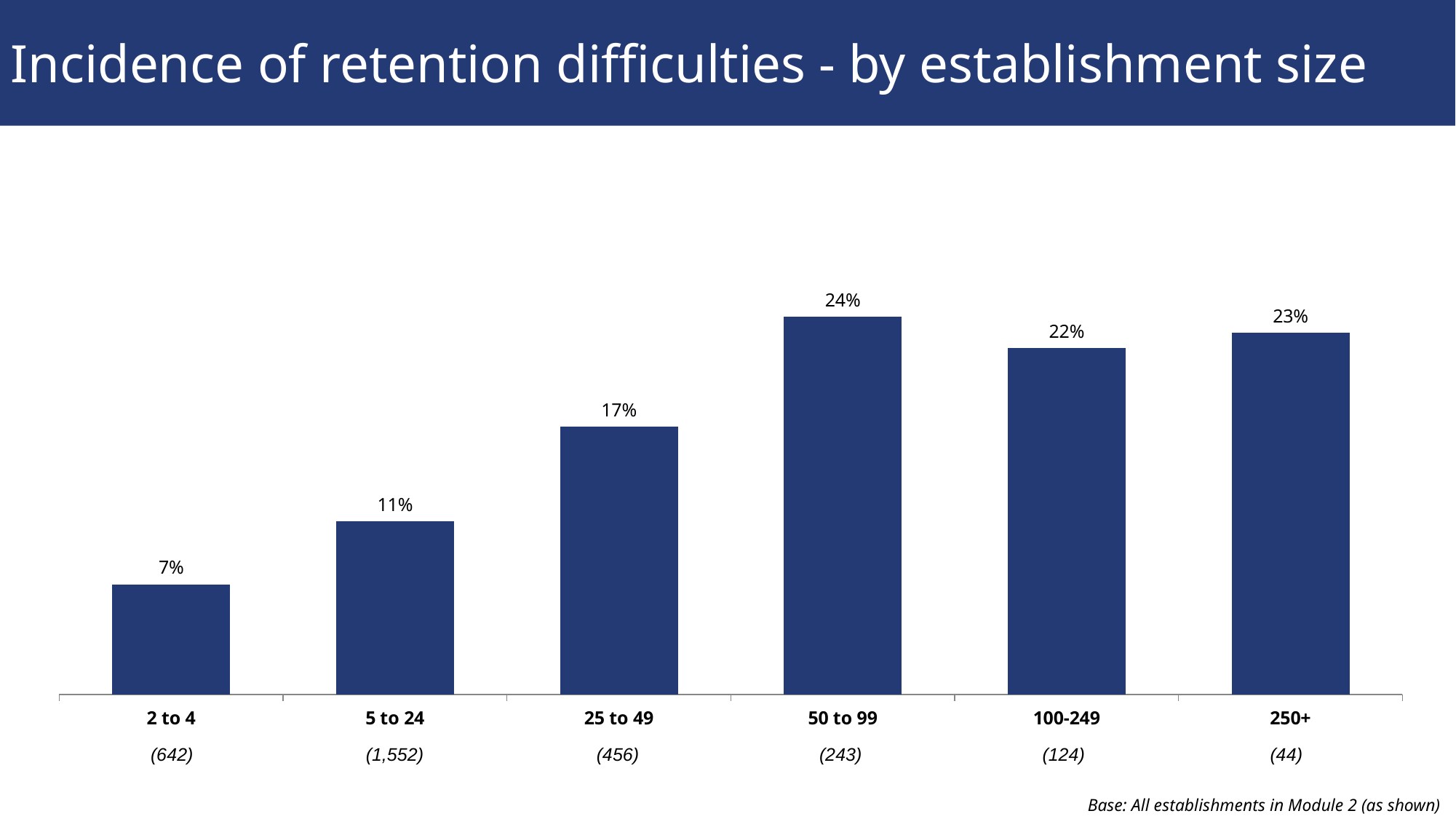
How many establishment size bands are shown on the chart? 6 Which establishment size band has the highest incidence of retention difficulties? 50 to 99 What is the difference in percentage points between the 50 to 99 band and the 100-249 band? 2 percentage points Which establishment size band has the lowest incidence of retention difficulties? 2 to 4 What kind of chart is shown on the slide? Bar chart What is the difference in percentage points between the 25 to 49 band and the 5 to 24 band? 6 percentage points Which has a higher incidence of retention difficulties: the 100-249 band or the 250+ band? 250+ What is the title of the chart on the slide? Incidence of retention difficulties - by establishment size What is the value shown for the 250+ establishment size band? 23% What is the value shown for the 50 to 99 establishment size band? 24% What is the incidence of retention difficulties for establishments with 2 to 4 employees? 7% What is the base (number of establishments) shown for the 5 to 24 band? 1,552